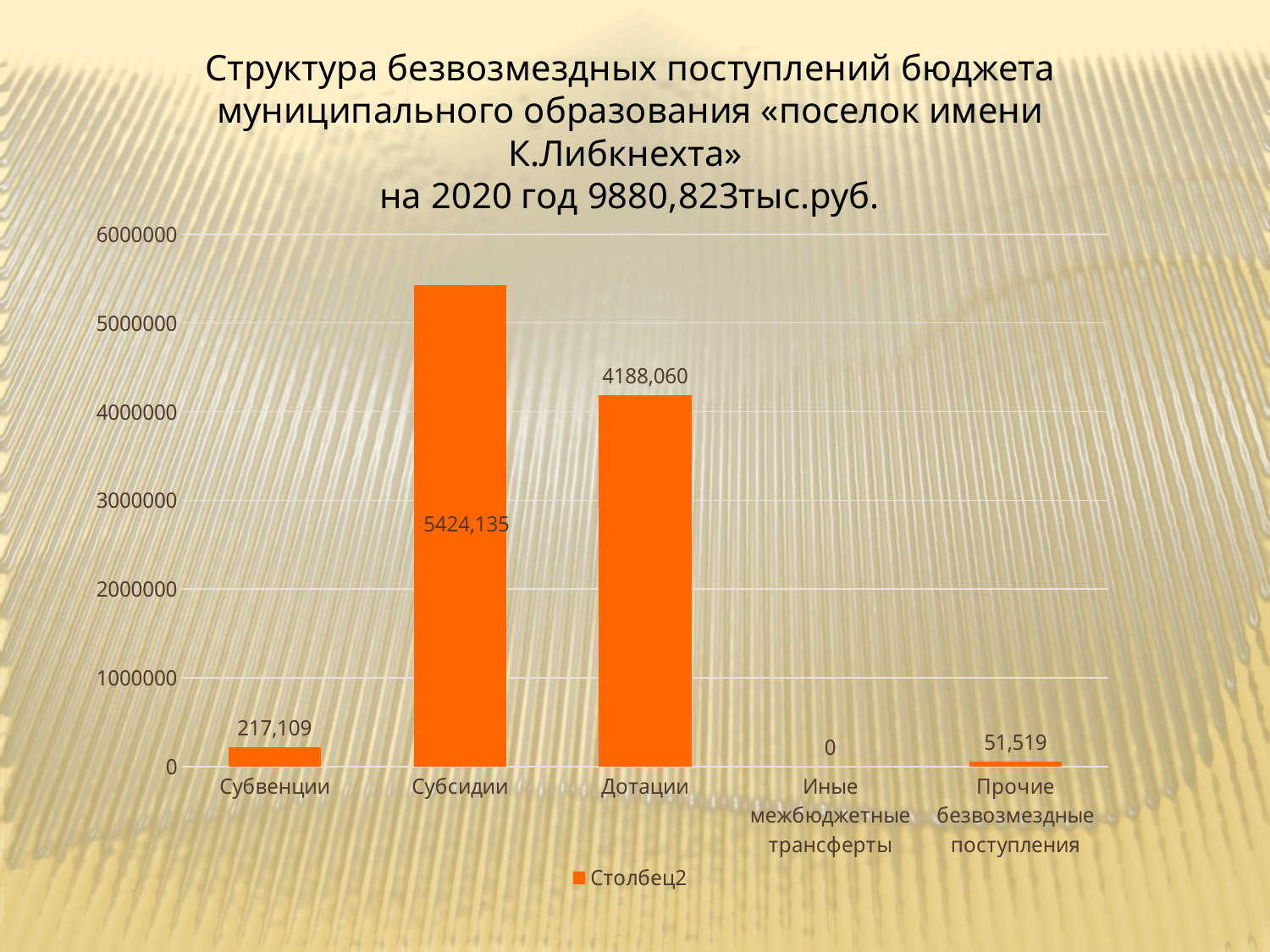
Which category has the lowest value? Иные межбюджетные трансферты What is the value for Прочие безвозмездные поступления? 51,519 What is the value for Иные межбюджетные трансферты? 0 What is the difference between the values for Субвенции and Прочие безвозмездные поступления? 165,590 What is the value for Дотации? 4188,060 What is the difference between the values for Субсидии and Дотации? 1236,075 How many categories are shown on the x axis? 5 What is the value for Субвенции? 217,109 What kind of chart is shown on the slide? Bar chart Which category has the highest value? Субсидии Which is larger, the value for Субвенции or the value for Прочие безвозмездные поступления? Субвенции What is the value for Субсидии? 5424,135